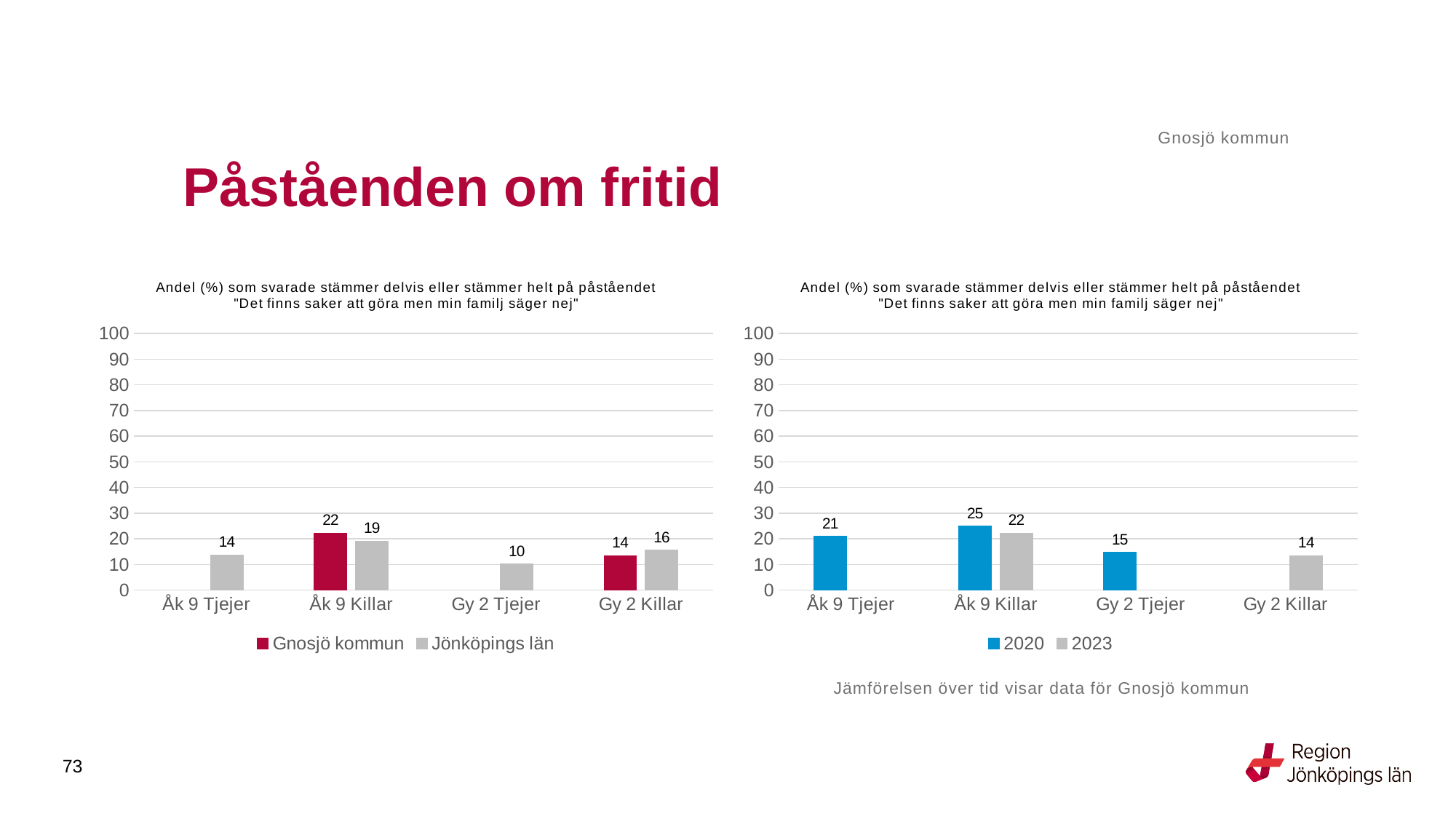
In the left chart, what is the difference between Gnosjö kommun and Jönköpings län for Åk 9 Killar? 3 In the left chart, what is the value for Gnosjö kommun for Gy 2 Killar? 14 In the left chart, how many series does the legend list? 2 In the right chart, what is the difference between the 2020 and 2023 values for Åk 9 Killar? 3 In the left chart, what is the value for Jönköpings län for Gy 2 Tjejer? 10 In the right chart, what is the 2023 value for Gy 2 Killar? 14 What kind of chart is the right chart? Bar chart In the right chart, which category has the highest 2020 value? Åk 9 Killar In the right chart, what is the 2020 value for Åk 9 Tjejer? 21 In the left chart, which category has the lowest Jönköpings län value? Gy 2 Tjejer In the left chart, what is the value for Jönköpings län for Åk 9 Killar? 19 In the right chart, which is larger for Åk 9 Killar, the 2020 value or the 2023 value? 2020